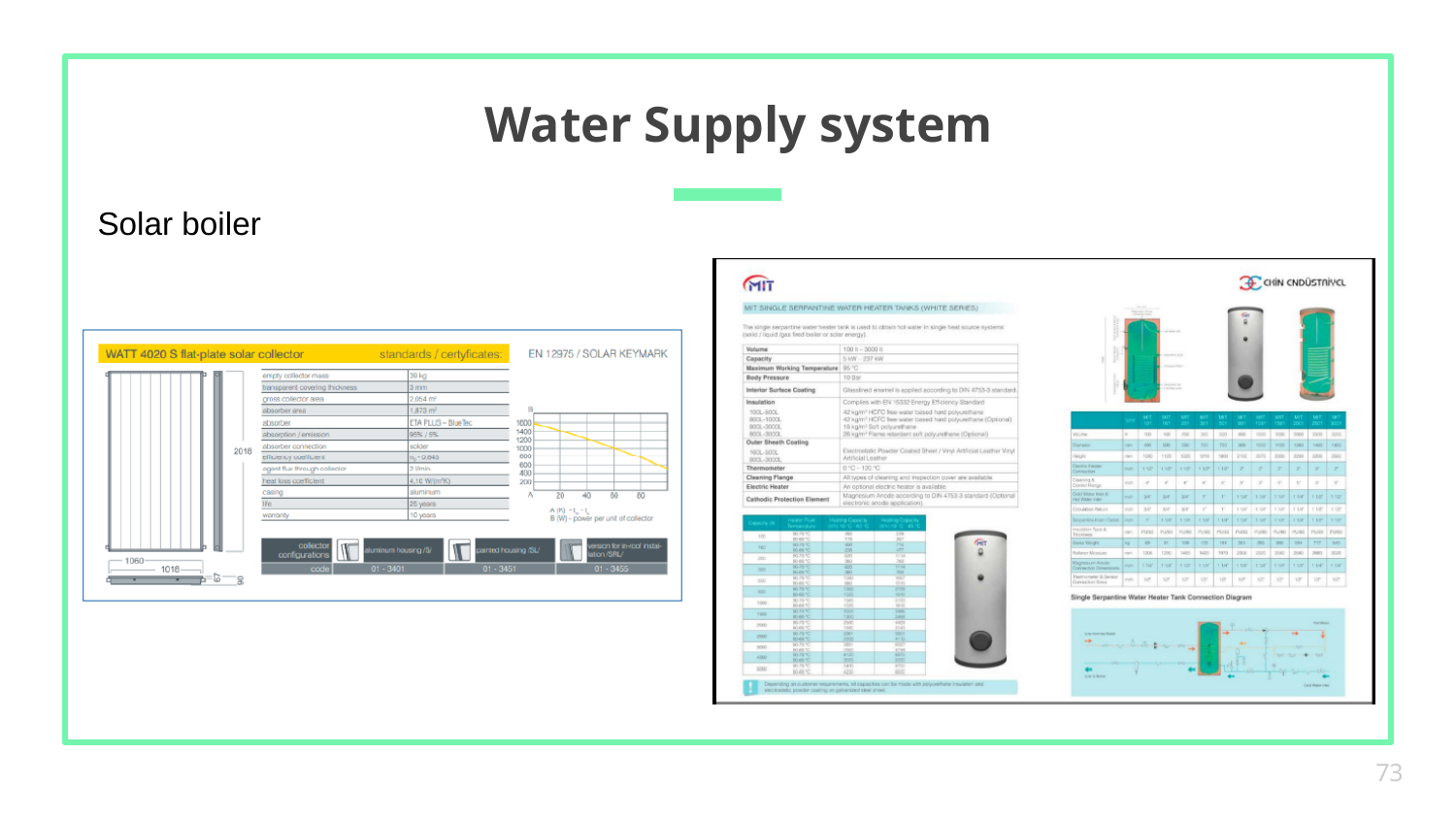
How many numbered tick labels are shown on the x-axis of the line chart on the WATT 4020 S solar collector datasheet? 4 In the line chart on the WATT 4020 S solar collector datasheet, is the value at x = 80 greater or less than 1000? less In the line chart on the WATT 4020 S solar collector datasheet, what does the B (W) axis represent according to the caption? power per unit of collector In the line chart on the WATT 4020 S solar collector datasheet, does the plotted value rise or fall as the x-axis value increases? fall In the line chart on the WATT 4020 S solar collector datasheet, is the value at x = 20 greater or less than 1000? greater What kind of chart is shown in the WATT 4020 S flat-plate solar collector datasheet on the left? line chart In the line chart on the WATT 4020 S solar collector datasheet, what is the highest tick label on the y-axis? 1600